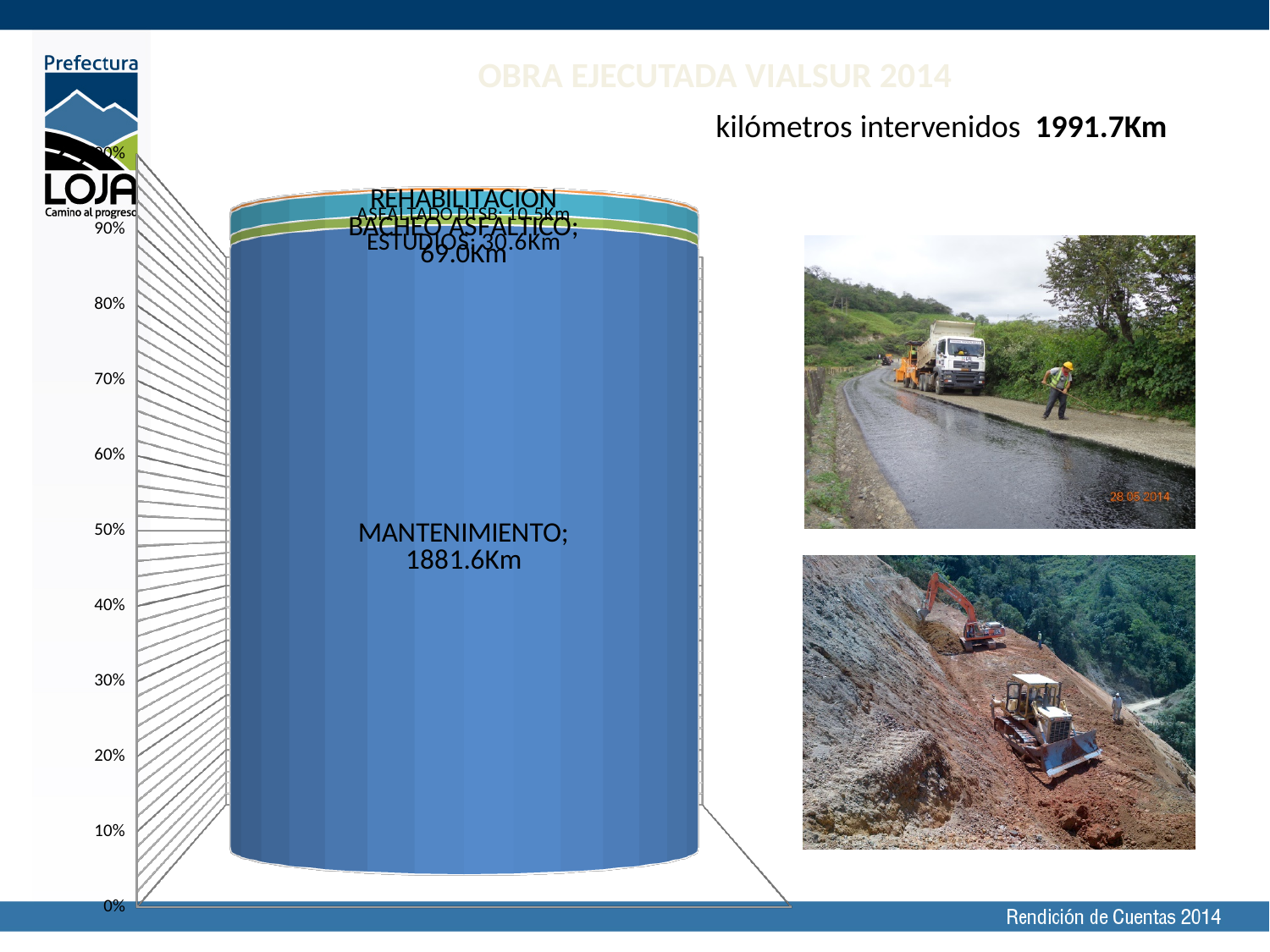
Which category has the largest value on the chart? MANTENIMIENTO What kind of chart is shown on the slide? Stacked bar chart What is the highest percentage tick shown on the vertical axis? 100% What is the difference between MANTENIMIENTO and BACHEO ASFALTICO? 1812.6Km What value is shown for MANTENIMIENTO on the chart? 1881.6Km What is the title of the chart? OBRA EJECUTADA VIALSUR 2014 What value is shown for ESTUDIOS on the chart? 30.6Km What value is shown for BACHEO ASFALTICO on the chart? 69.0Km What is the difference between BACHEO ASFALTICO and ESTUDIOS? 38.4Km Which is larger, BACHEO ASFALTICO or ESTUDIOS? BACHEO ASFALTICO What total of kilómetros intervenidos is stated on the slide? 1991.7Km